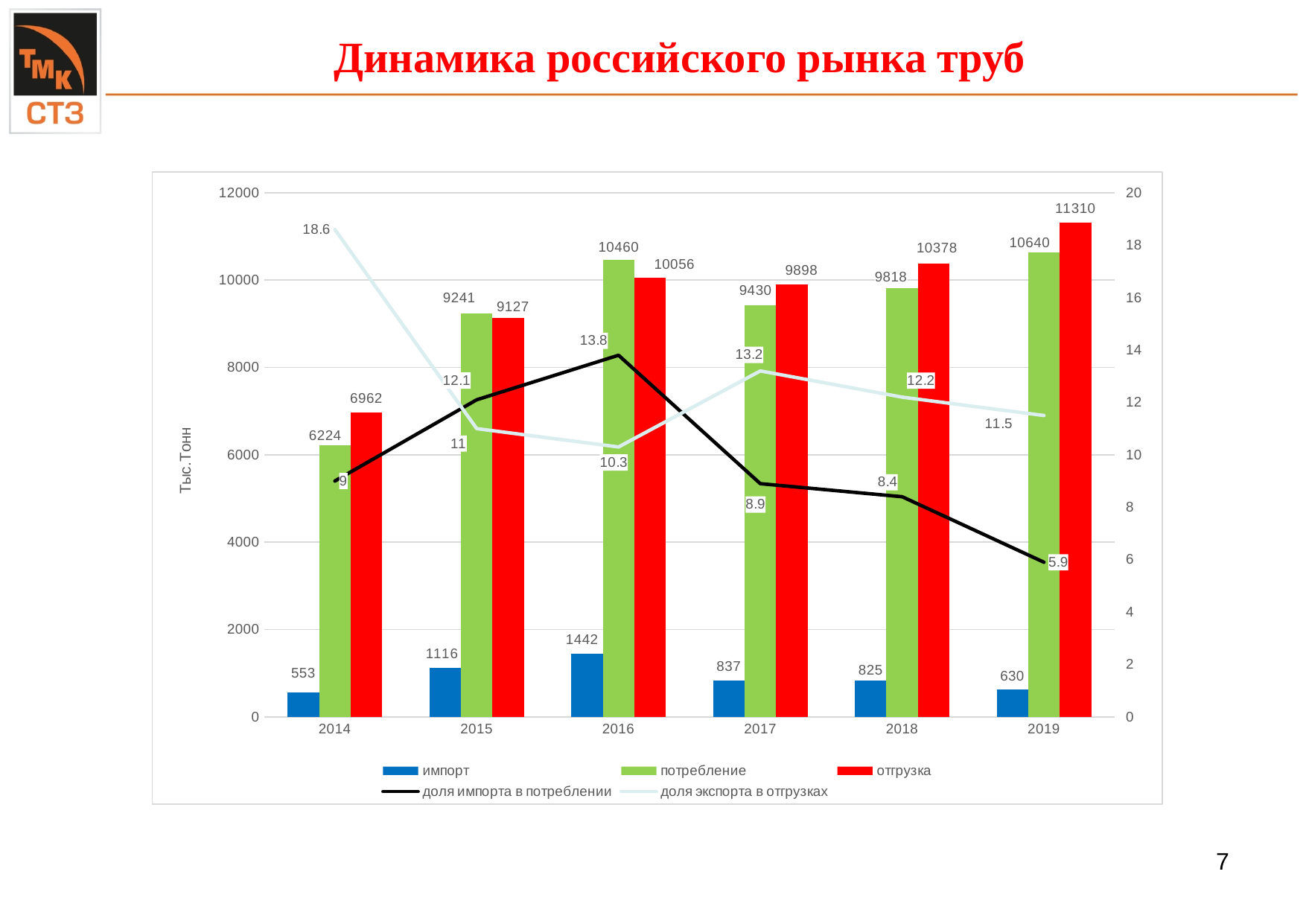
What is the value of доля экспорта в отгрузках for 2014? 18.6 What is the difference between отгрузка and потребление in 2019? 670 In which year is потребление the highest? 2019 In which year is импорт the lowest? 2014 How many years are shown on the x axis? 6 Which is larger in 2015: потребление or отгрузка? потребление What is the value of импорт for 2016? 1442 What is the title of the slide? Динамика российского рынка труб How many series does the legend list? 5 What kind of chart is shown on the slide? Combined bar and line chart What is the value of отгрузка for 2019? 11310 Does доля импорта в потреблении rise or fall from 2016 to 2019? fall